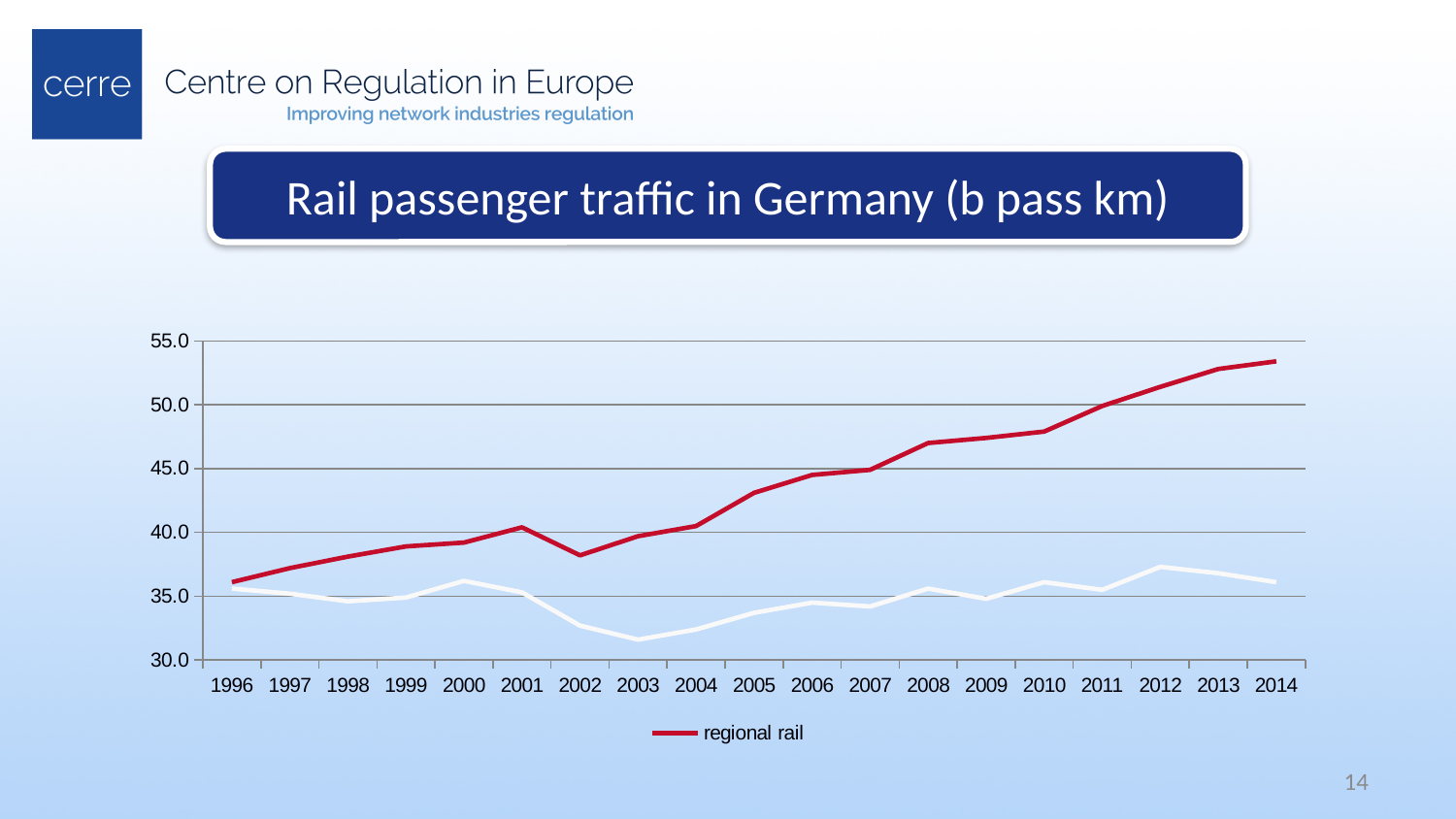
Is the regional rail value for 2014 greater or less than 50.0? greater What colour is the regional rail line? red How many series does the legend list? 1 Is the regional rail value for 2008 greater or less than 45.0? greater What kind of chart is shown on the slide? line chart In which year is the regional rail value lowest? 1996 Does the regional rail line generally rise or fall from 1996 to 2014? rise How many years are shown on the x axis? 19 In which year is the regional rail value highest? 2014 What is the title of the chart? Rail passenger traffic in Germany (b pass km) Is the regional rail value for 1996 greater or less than 40.0? less Which year has the larger regional rail value, 2001 or 2002? 2001